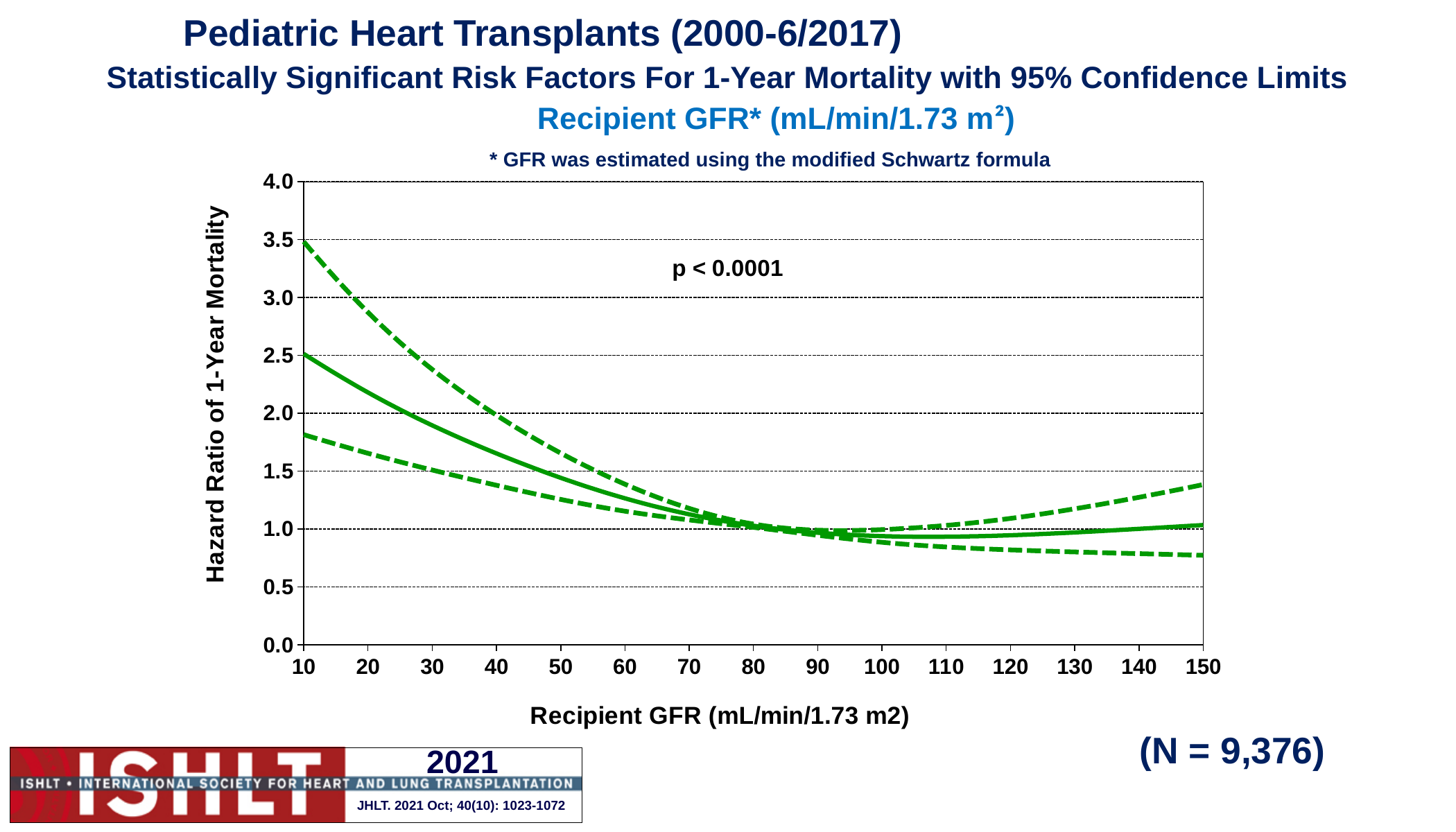
At which recipient GFR value on the x axis is the solid hazard ratio line highest? 10 How many lines are plotted on the chart? 3 What is the label of the y axis? Hazard Ratio of 1-Year Mortality What kind of chart is shown on the slide? line chart At a recipient GFR of 10, is the upper dashed confidence limit greater or less than 3.0? greater At a recipient GFR of 10, is the hazard ratio on the solid line greater or less than 2.0? greater At a recipient GFR of 10, is the lower dashed confidence limit greater or less than 2.0? less Between a recipient GFR of 10 and 80, does the solid hazard ratio line rise or fall? fall What p-value is printed on the chart? p < 0.0001